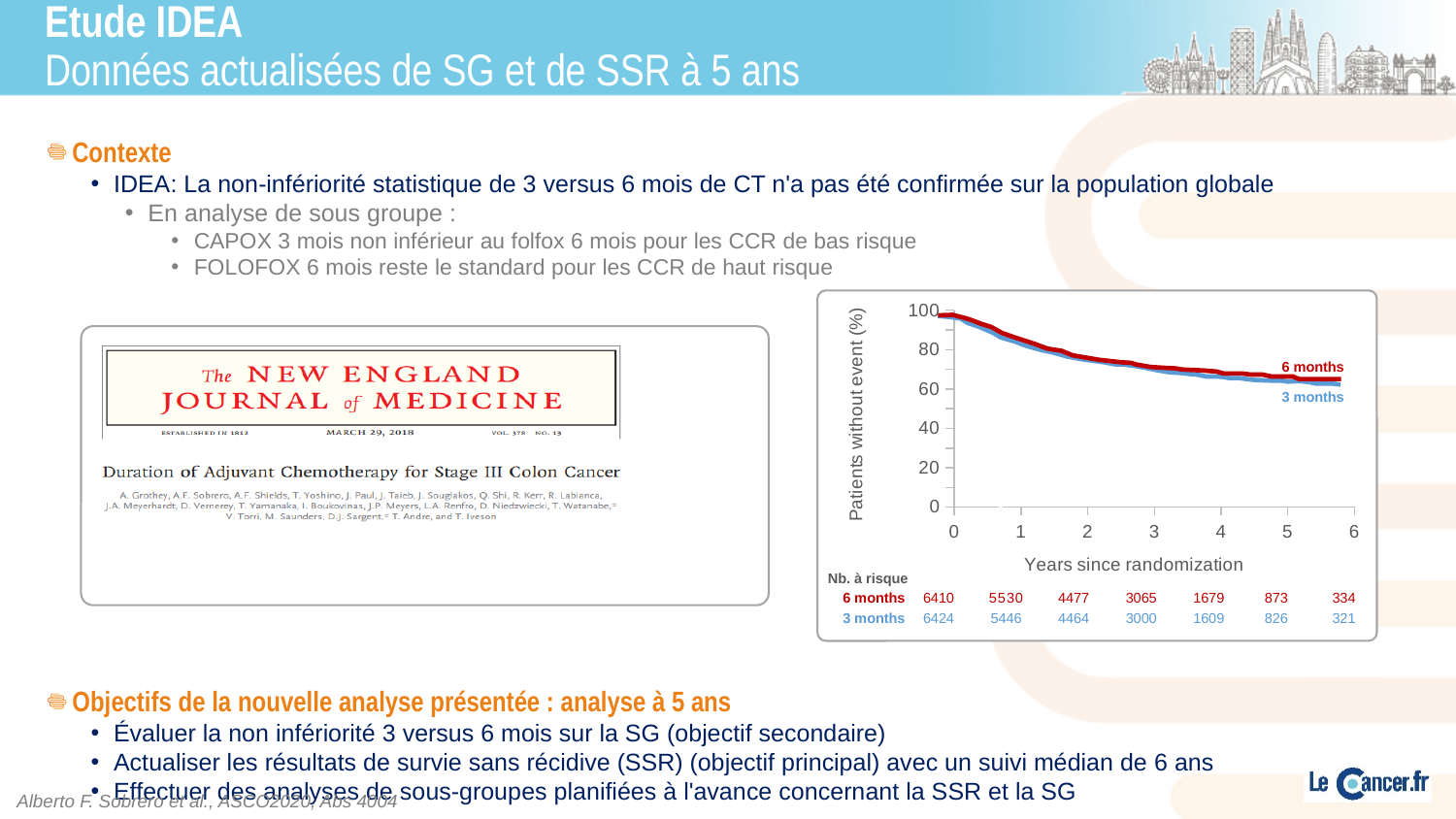
What is the label of the y axis of the chart? Patients without event (%) Do the curves rise or fall as years since randomization increase? fall What colour is the 6 months curve? red In the number-at-risk table, how many patients were at risk in the 6 months group at year 0? 6410 How many series are plotted in the chart? 2 Is the value for the 3 months curve at year 5 greater or less than 60? greater In the number-at-risk table, how many patients were at risk in the 3 months group at year 3? 3000 In the number-at-risk table, how many patients were at risk in the 6 months group at year 6? 334 What kind of chart is shown on the slide? line chart Is the value for the 6 months curve at year 3 greater or less than 80? less In the number-at-risk table, what is the difference between the 3 months and 6 months groups at year 0? 14 In the number-at-risk table, which group had more patients at risk at year 4, 6 months or 3 months? 6 months